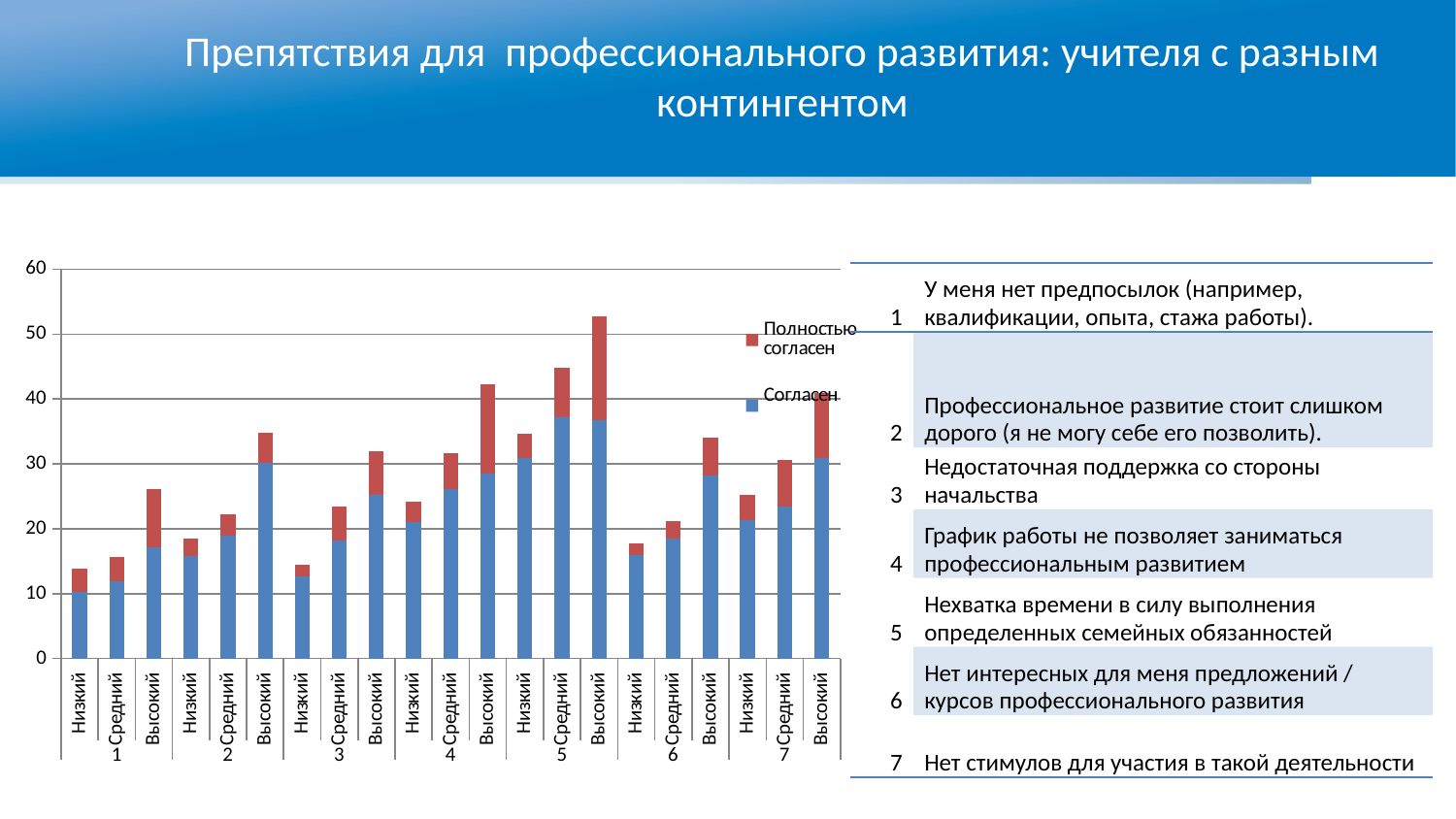
Within group 1, do the bar totals rise or fall going from Низкий to Высокий? rise Is the total for Низкий in group 1 greater or less than 20? less How many numbered obstacle groups are shown along the x axis? 7 What are the two series named in the legend? Полностью согласен and Согласен Which colour represents the series "Согласен"? blue Which is larger: the total for Высокий in group 5 or the total for Низкий in group 6? Высокий in group 5 How many series does the chart legend list? 2 What kind of chart is shown on the slide? stacked bar chart Is the total for Высокий in group 5 greater or less than 50? greater Is the total for Высокий in group 2 greater or less than 30? greater How many bars are plotted in the chart? 21 Which bar has the highest total in the chart? Высокий in group 5